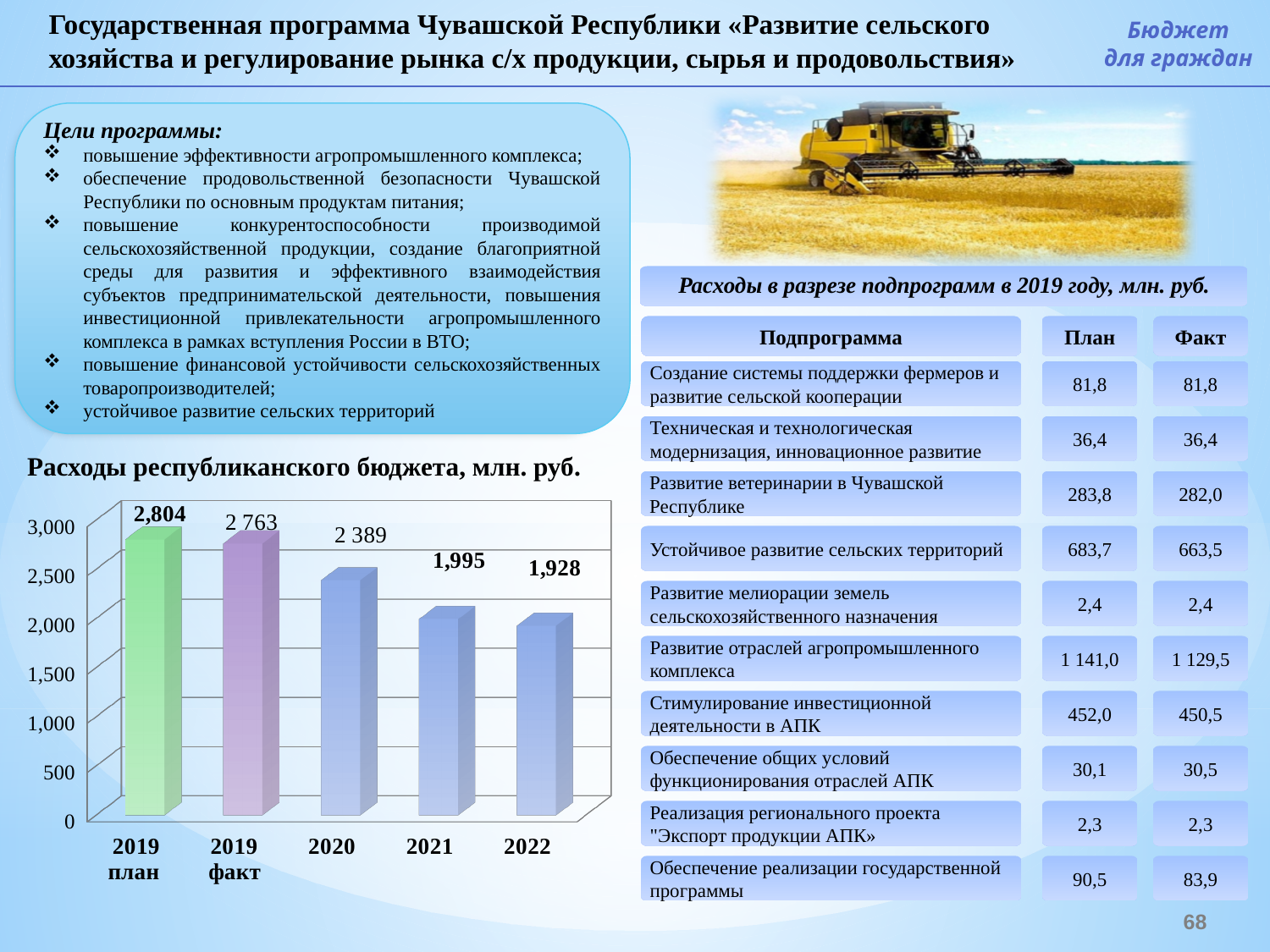
What kind of chart is 'Расходы республиканского бюджета, млн. руб.'? bar chart Is the value for 2020 in the chart 'Расходы республиканского бюджета, млн. руб.' greater or less than 2,500? less What is the value for 2022 in the chart 'Расходы республиканского бюджета, млн. руб.'? 1,928 Which category has the lowest value in the chart 'Расходы республиканского бюджета, млн. руб.'? 2022 What is the difference between the 2020 and 2021 values in the chart 'Расходы республиканского бюджета, млн. руб.'? 394 Which category has the highest value in the chart 'Расходы республиканского бюджета, млн. руб.'? 2019 план What is the value for 2019 план in the chart 'Расходы республиканского бюджета, млн. руб.'? 2,804 Which is larger in the chart 'Расходы республиканского бюджета, млн. руб.': the value for 2021 or the value for 2022? 2021 What is the value for 2019 факт in the chart 'Расходы республиканского бюджета, млн. руб.'? 2 763 What is the difference between the 2019 план and 2019 факт values in the chart 'Расходы республиканского бюджета, млн. руб.'? 41 What is the value for 2020 in the chart 'Расходы республиканского бюджета, млн. руб.'? 2 389 How many bars are shown in the chart 'Расходы республиканского бюджета, млн. руб.'? 5